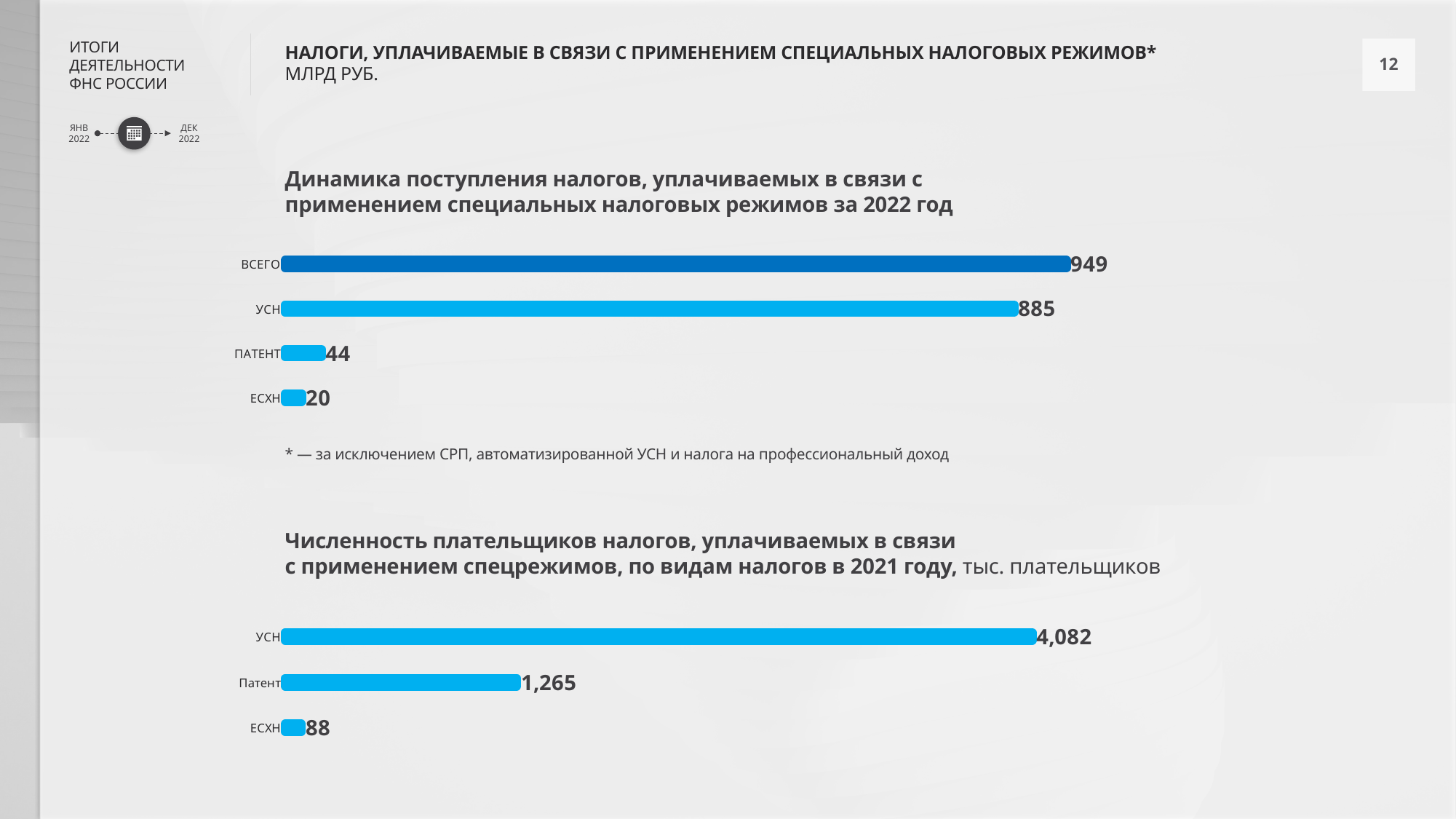
In the top chart (Динамика поступления налогов), which category has the lowest value? ЕСХН In the bottom chart (Численность плательщиков), what is the difference between the values for Патент and ЕСХН? 1,177 In the top chart (Динамика поступления налогов), what is the value for УСН? 885 What type of chart is the bottom chart (Численность плательщиков)? Bar chart In the top chart (Динамика поступления налогов), what is the difference between the values for УСН and ПАТЕНТ? 841 In the top chart (Динамика поступления налогов), how many bars are shown? 4 In the top chart (Динамика поступления налогов), what is the value for ВСЕГО? 949 In the bottom chart (Численность плательщиков), what is the value for УСН? 4,082 In the top chart (Динамика поступления налогов), what is the value for ПАТЕНТ? 44 In the bottom chart (Численность плательщиков), what is the value for Патент? 1,265 In the bottom chart (Численность плательщиков), which is larger, the value for Патент or the value for ЕСХН? Патент In the bottom chart (Численность плательщиков), which category has the highest value? УСН